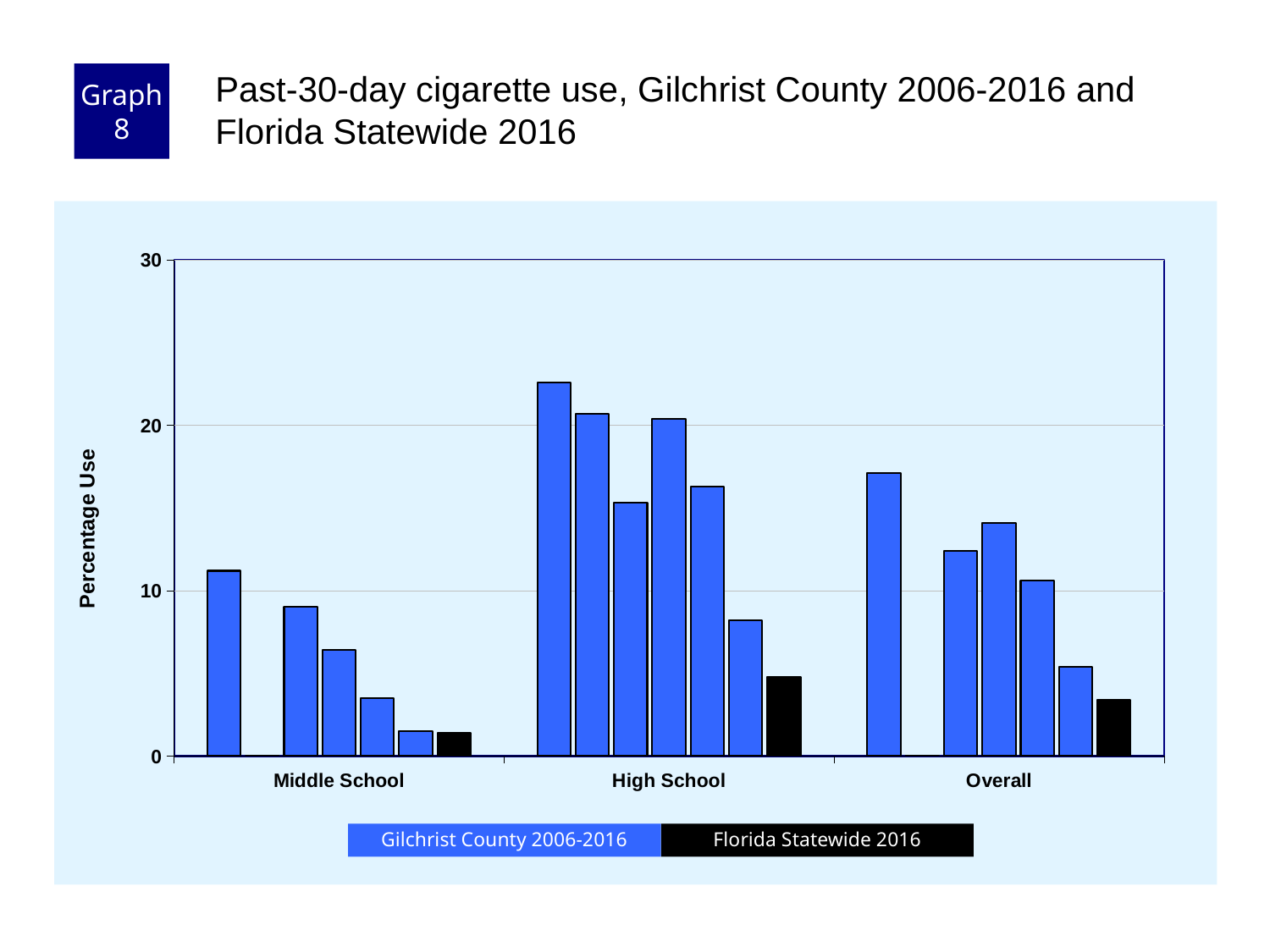
Which category has the lowest Florida Statewide 2016 bar? Middle School Which category has the tallest bar overall? High School Is the Florida Statewide 2016 value larger for High School or for Middle School? High School What is the label on the y axis? Percentage Use Do the Gilchrist County 2006-2016 bars in the Middle School group rise or fall from left to right? fall Is the tallest Gilchrist County 2006-2016 bar in the Overall group greater or less than 20? less What kind of chart is shown on the slide? bar chart Is the tallest Gilchrist County 2006-2016 bar in the Middle School group greater or less than 10? greater Is the Florida Statewide 2016 bar for High School greater or less than 10? less How many categories are shown on the x axis? 3 How many series does the legend list? 2